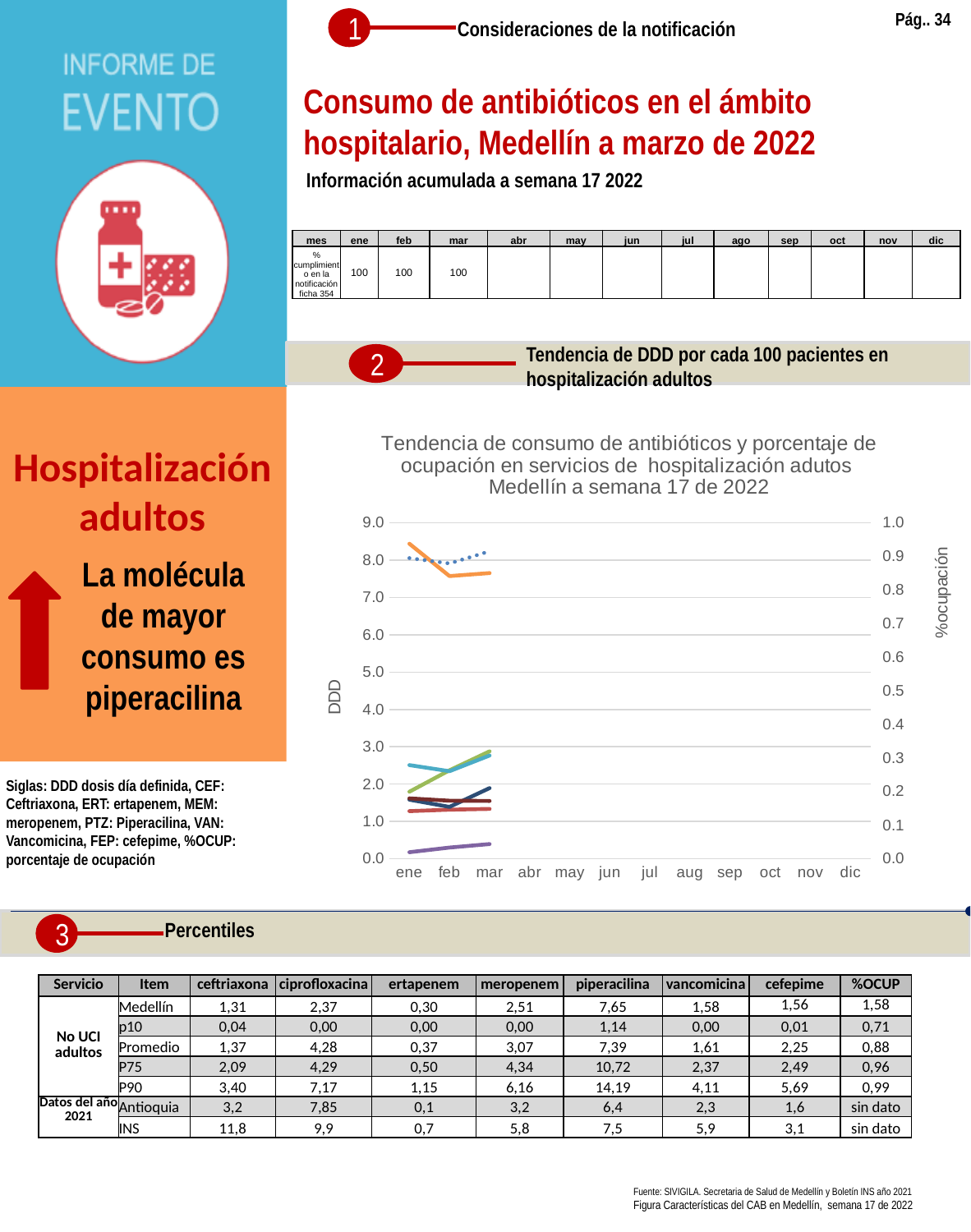
How many month categories are shown along the x axis of the chart? 12 What kind of chart is shown on the slide? line chart Is the value of the lowest line in mar greater or less than 1.0 on the DDD axis? less Is the value of the topmost solid line in ene greater or less than 8.0 on the DDD axis? greater For how many months does the chart show plotted data? 3 Does the lowest line rise or fall from ene to mar? rise What is the label of the right-hand vertical axis of the chart? %ocupación Is the value of the topmost solid line in feb greater or less than 8.0 on the DDD axis? less Does the topmost solid line rise or fall from ene to feb? fall What is the title of the chart? Tendencia de consumo de antibióticos y porcentaje de ocupación en servicios de hospitalización adutos Medellín a semana 17 de 2022